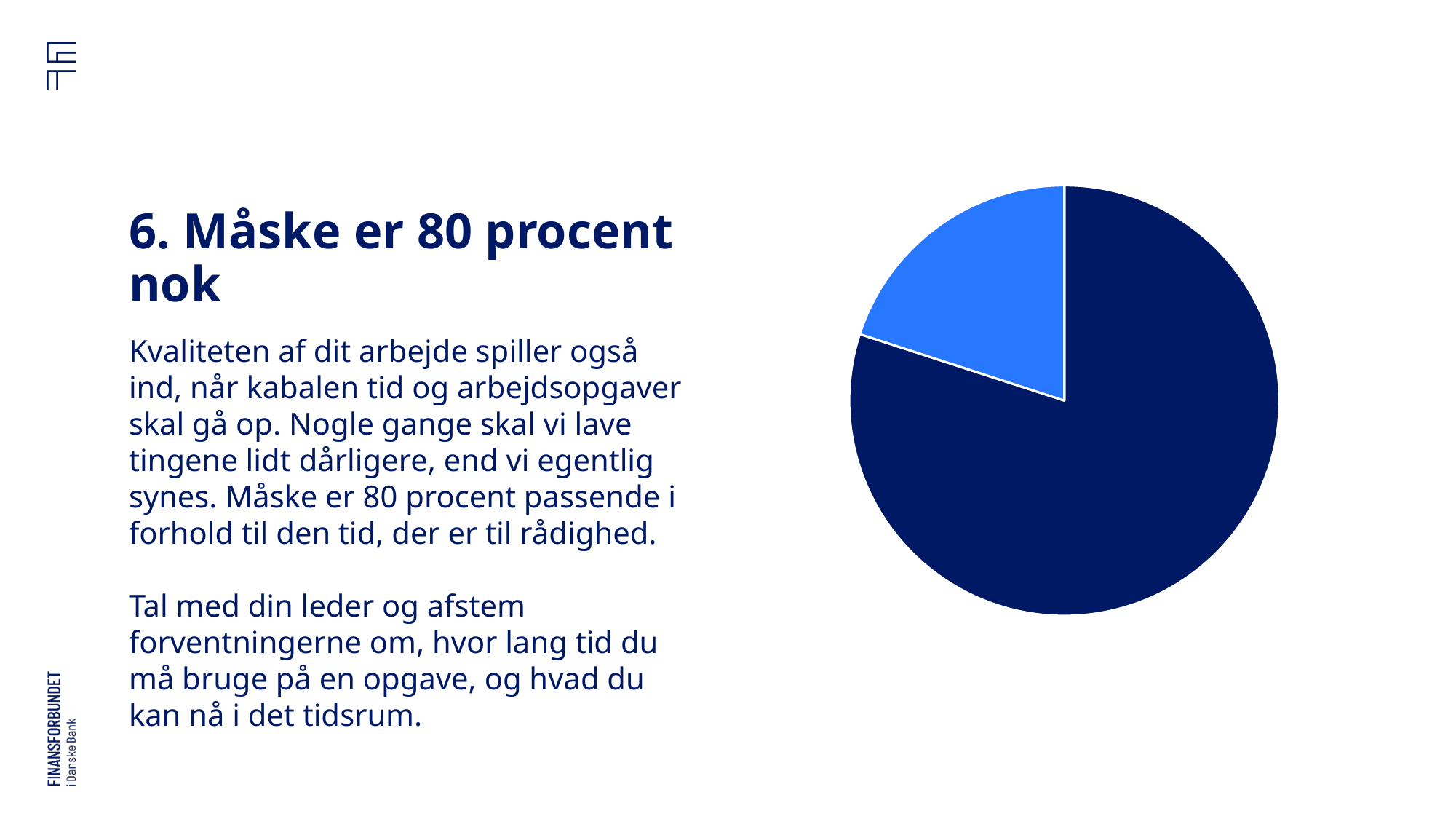
How many slices does the pie chart have? 2 Which slice of the pie chart is the smallest? the light blue slice Which slice of the pie chart is the largest? the dark blue slice Does the light blue slice cover more or less than half of the pie chart? less Which slice of the pie chart is larger, the dark blue one or the light blue one? the dark blue one Does the pie chart have a legend? no What two colours are used for the slices of the pie chart? dark blue and light blue Does the dark blue slice cover more or less than half of the pie chart? more What kind of chart is shown on the slide? pie chart